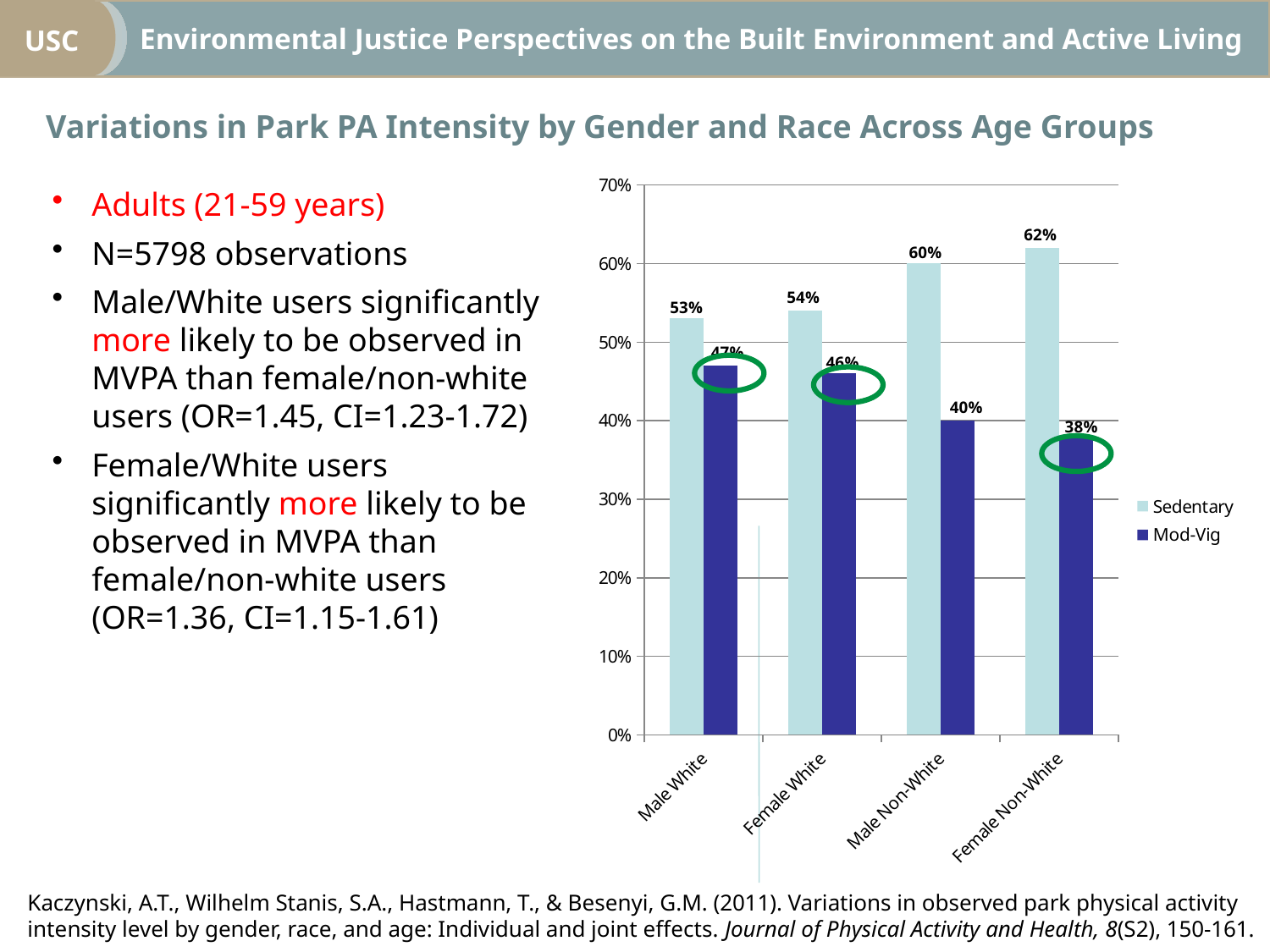
What is the difference between the Sedentary and Mod-Vig values for Male Non-White? 20% Which is larger, the Mod-Vig value for Male White or the Mod-Vig value for Female Non-White? Male White What is the Sedentary value for Female Non-White? 62% Which category has the highest Sedentary value? Female Non-White Which series is shown in dark blue in the legend? Mod-Vig What is the Mod-Vig value for Male Non-White? 40% How many categories are shown on the x axis? 4 What kind of chart is shown on the slide? Bar chart How many series does the legend list? 2 What is the Mod-Vig value for Female White? 46% Which category has the lowest Mod-Vig value? Female Non-White What is the Sedentary value for Male White? 53%